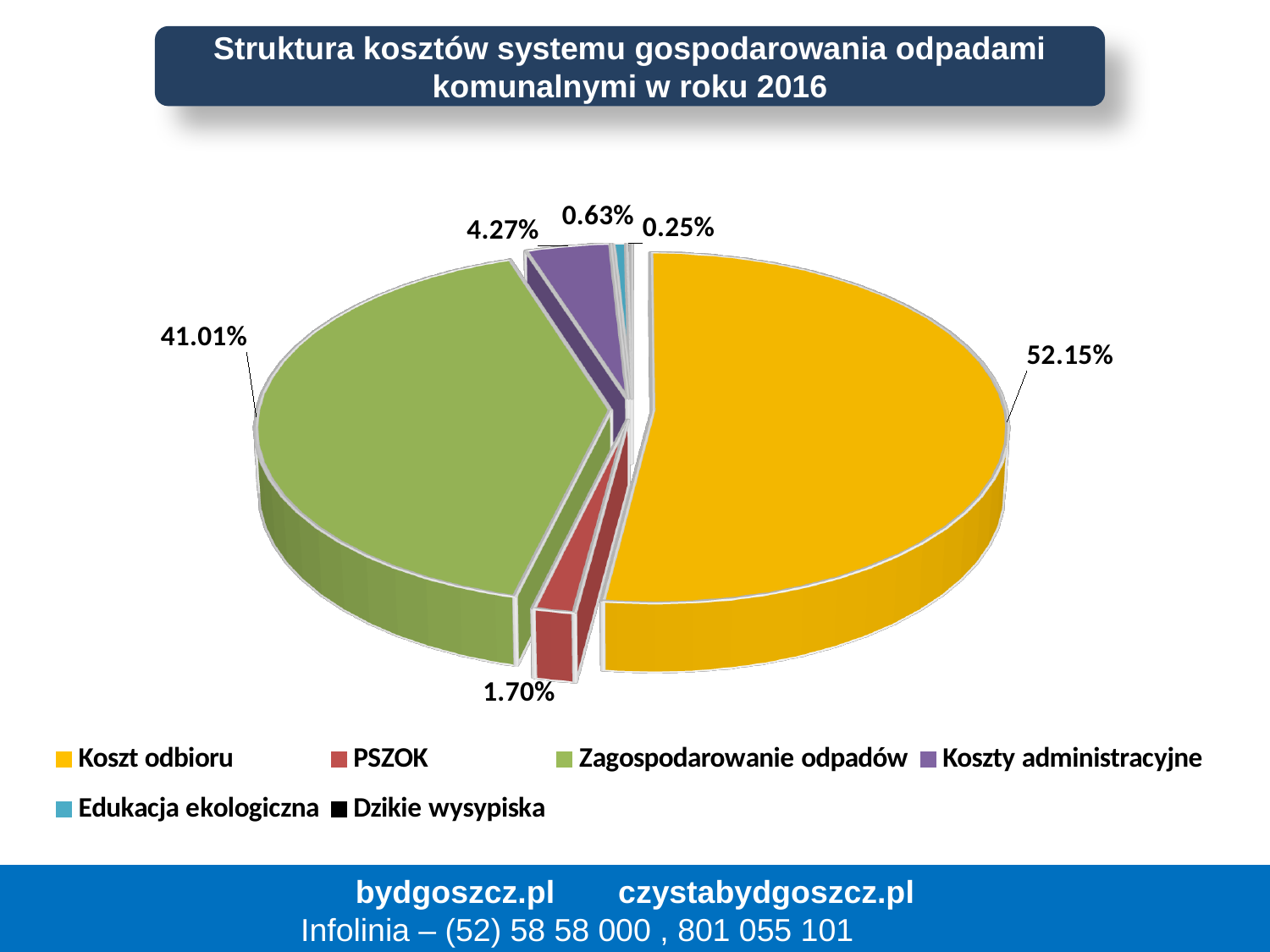
What is the difference in percentage points between Koszt odbioru and Zagospodarowanie odpadów? 11.14 What share of costs does Koszty administracyjne represent? 4.27% What share of costs does Koszt odbioru represent? 52.15% What share of costs does Zagospodarowanie odpadów represent? 41.01% Which is larger, the share for PSZOK or the share for Koszty administracyjne? Koszty administracyjne What kind of chart is shown on the slide? pie chart How many categories does the legend list? 6 Which category has the smallest share of the pie? Dzikie wysypiska What is the title of the chart? Struktura kosztów systemu gospodarowania odpadami komunalnymi w roku 2016 Which category has the largest share of the pie? Koszt odbioru